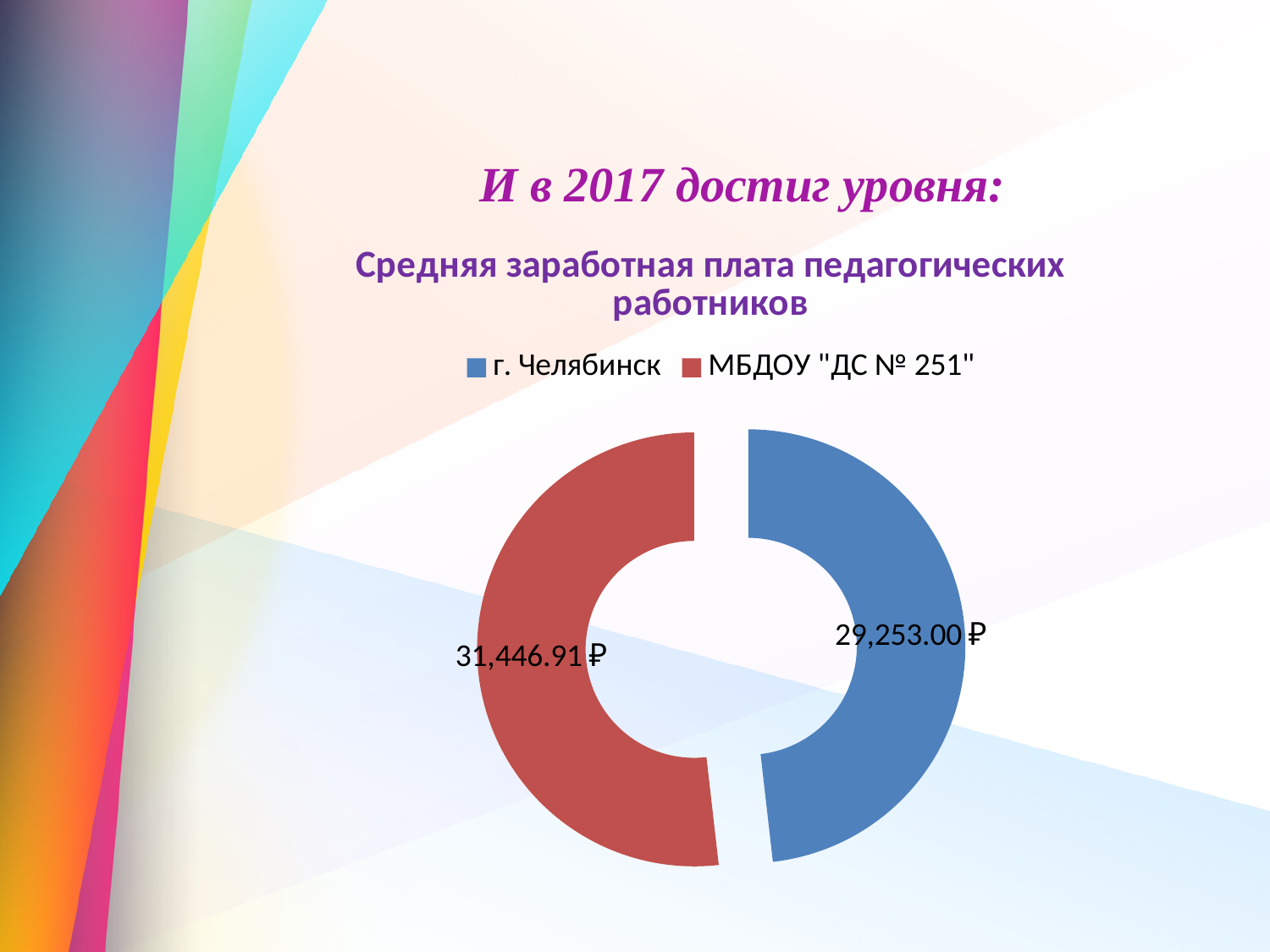
Which category has the highest value? МБДОУ "ДС № 251" What is the difference between the value for МБДОУ "ДС № 251" and the value for г. Челябинск? 2,193.91 ₽ What kind of chart is shown on the slide? Doughnut (pie) chart What is the value shown for г. Челябинск? 29,253.00 ₽ What colour represents г. Челябинск in the chart? Blue Which is larger, the value for г. Челябинск or the value for МБДОУ "ДС № 251"? МБДОУ "ДС № 251" What is the title of the chart? Средняя заработная плата педагогических работников Which category has the lowest value? г. Челябинск What is the value shown for МБДОУ "ДС № 251"? 31,446.91 ₽ How many entries does the chart legend list? 2 What is the total of the two values shown in the chart? 60,699.91 ₽ How many slices does the doughnut chart have? 2